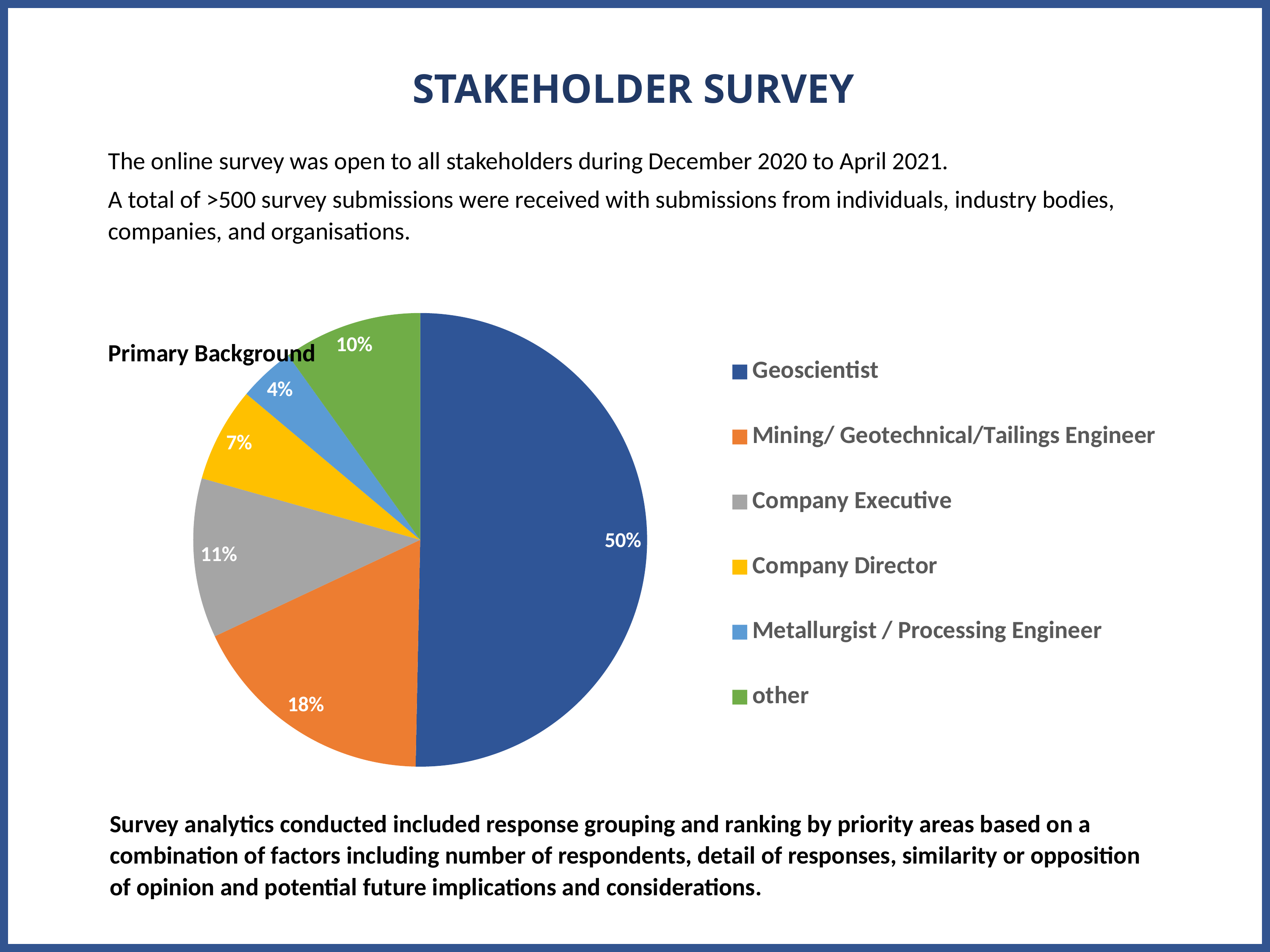
What is the value for Company Director? 7% What kind of chart is shown on the slide? Pie chart What is the value for Metallurgist / Processing Engineer? 4% Which category has the largest slice of the pie? Geoscientist What is the value for the 'other' category? 10% What is the value for Mining/ Geotechnical/Tailings Engineer? 18% What is the difference between the Geoscientist share and the Mining/ Geotechnical/Tailings Engineer share? 32% How many categories does the pie chart show? 6 What is the value for Company Executive? 11% What share of the pie does Geoscientist hold? 50% Which category has the smallest slice of the pie? Metallurgist / Processing Engineer Which is larger, Company Executive or other? Company Executive